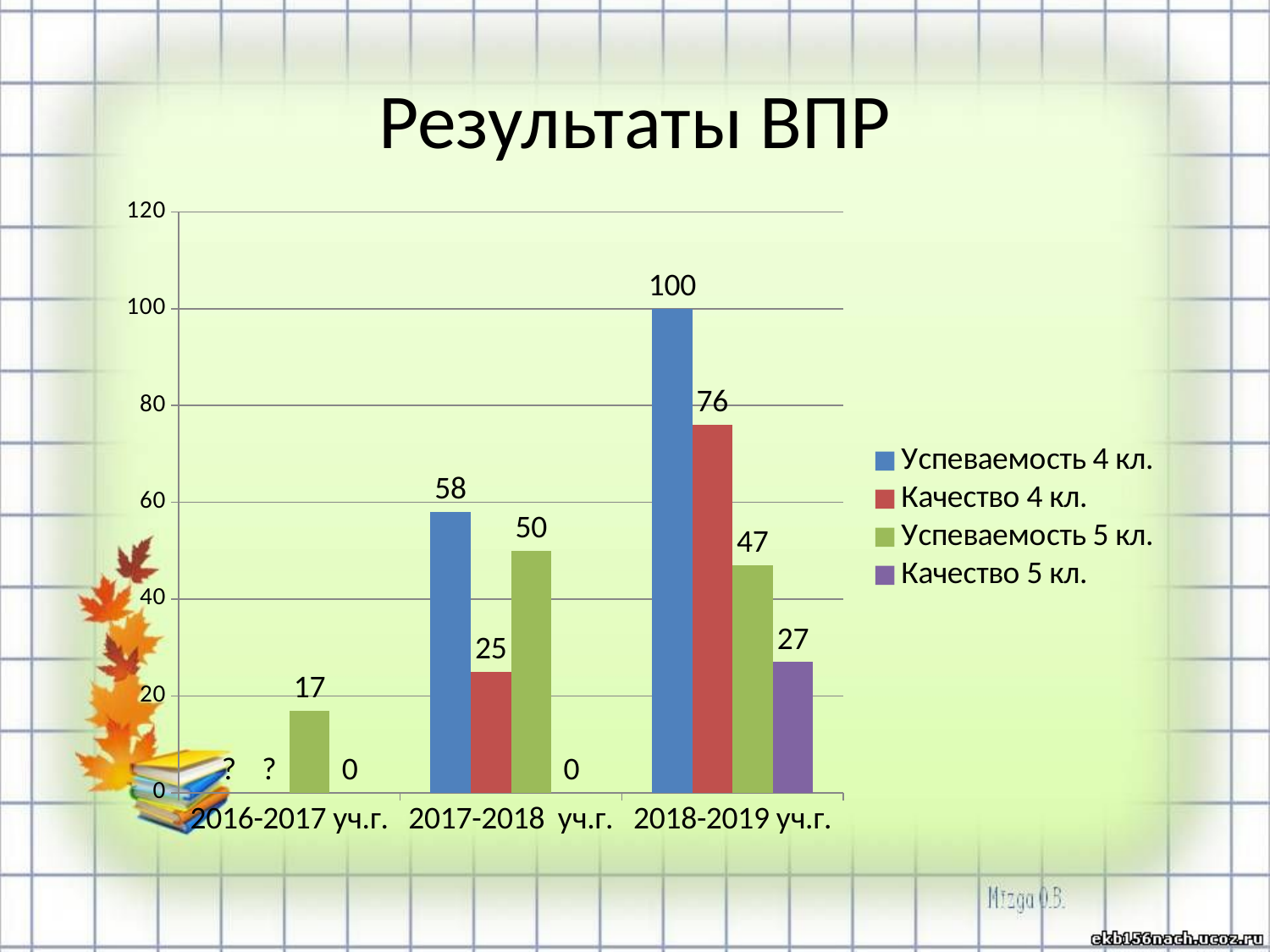
In which academic year is Качество 4 кл. highest? 2018-2019 уч.г. What is the difference between Успеваемость 4 кл. and Качество 4 кл. in 2018-2019 уч.г.? 24 What type of chart is shown on the slide? bar chart What is the title of the chart? Результаты ВПР How many series does the legend list? 4 How many academic-year categories are shown on the x axis? 3 What is the value of Качество 5 кл. for 2018-2019 уч.г.? 27 What is the value of Успеваемость 4 кл. for 2018-2019 уч.г.? 100 Which is larger in 2017-2018 уч.г.: Успеваемость 4 кл. or Успеваемость 5 кл.? Успеваемость 4 кл. What is the value of Качество 4 кл. for 2017-2018 уч.г.? 25 Does Успеваемость 4 кл. rise or fall from 2017-2018 уч.г. to 2018-2019 уч.г.? rise What is the value of Успеваемость 5 кл. for 2016-2017 уч.г.? 17